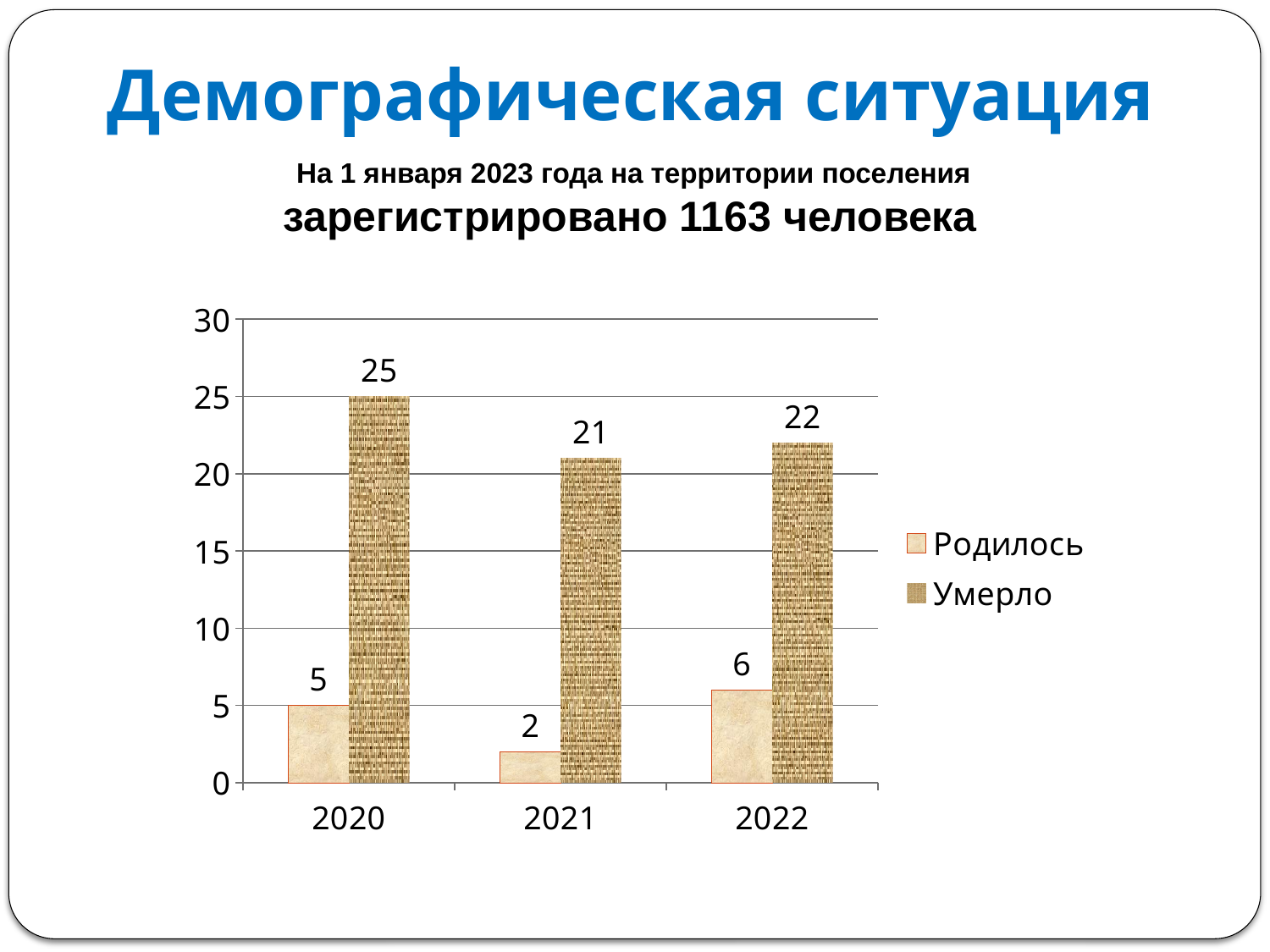
What are the two series named in the legend? Родилось, Умерло What kind of chart is shown on the slide? bar chart What is the difference between Умерло and Родилось in 2020? 20 How many series does the legend list? 2 In which year is the Родилось value lowest? 2021 What is the value for Умерло in 2021? 21 Is the value for Умерло in 2021 greater or less than 20? greater How many years are shown on the x axis? 3 What is the value for Умерло in 2022? 22 Which is larger in 2022: Родилось or Умерло? Умерло What is the value for Родилось in 2020? 5 In which year is the Умерло value highest? 2020